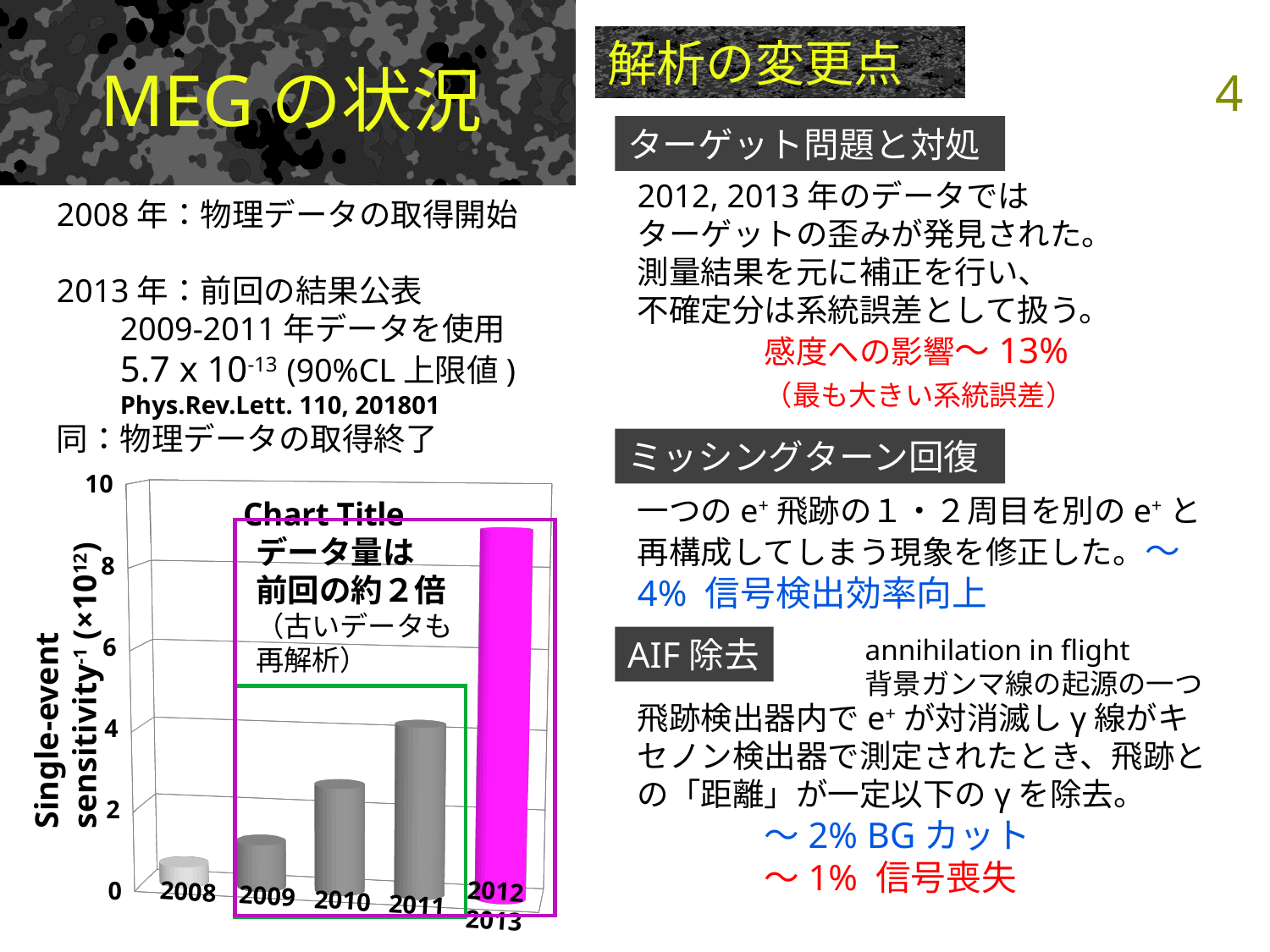
Is the value for 2012-2013 greater or less than 8? greater Which is larger, the value for 2011 or the value for 2010? 2011 How many bars (categories) does the chart show? 5 Is the value for 2011 greater or less than 6? less Is the value for 2009 greater or less than 2? less Which is larger, the value for 2009 or the value for 2012-2013? 2012-2013 Which category has the lowest value in the chart? 2008 What kind of chart is shown on the slide? bar chart What is the label of the vertical axis of the chart? Single-event sensitivity⁻¹ (×10¹²) What is the title printed on the chart? Chart Title Which category has the highest value in the chart? 2012-2013 Do the values rise or fall from 2008 to 2012-2013 along the x axis? rise